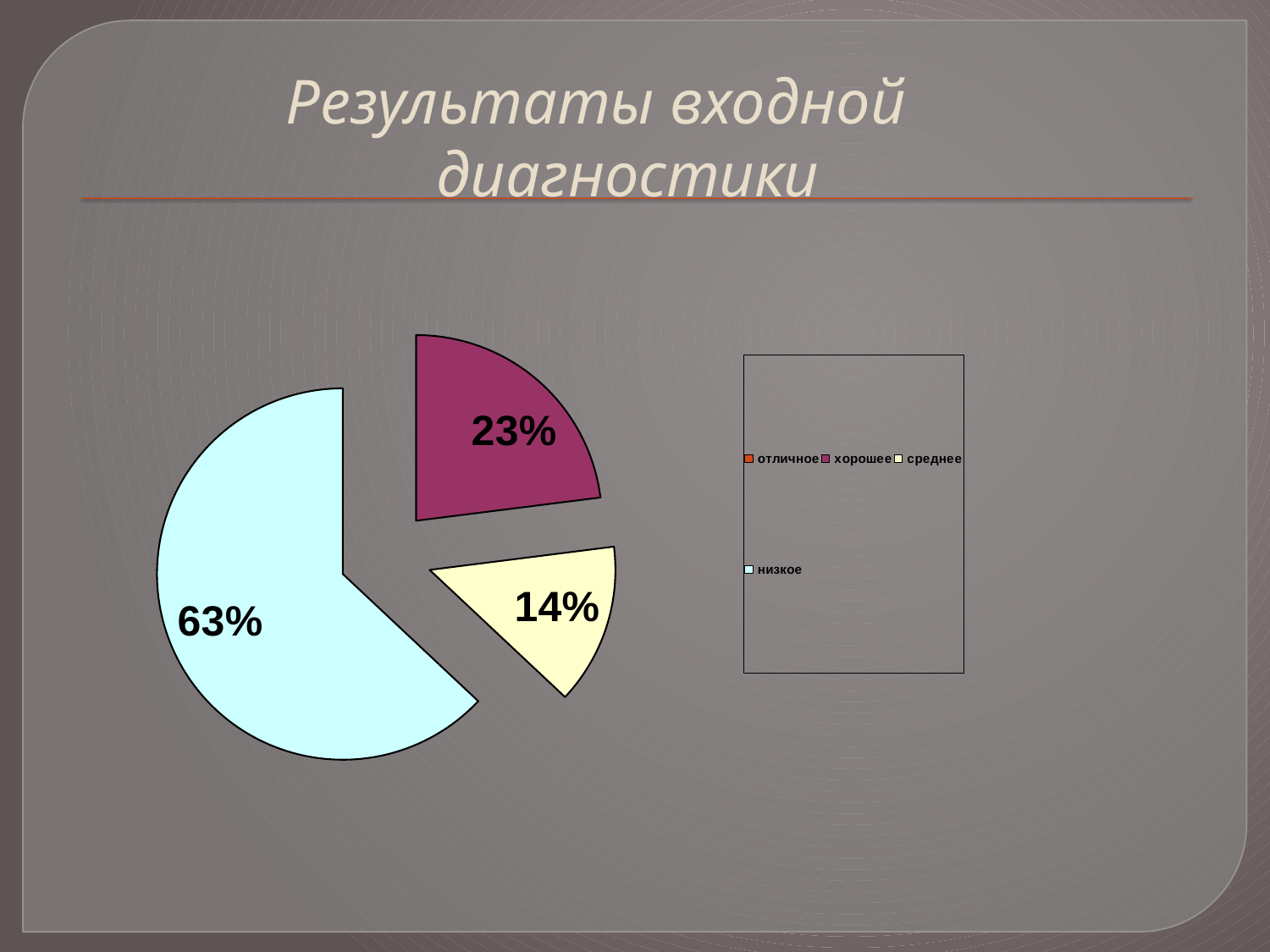
Which slice is larger, 'хорошее' or 'среднее'? хорошее What is the difference in percentage points between the 'низкое' and 'хорошее' slices? 40 Which of the visible slices is the smallest? среднее What share of the pie does the 'хорошее' slice represent? 23% What kind of chart is shown on the slide? pie chart How many entries does the legend list? 4 What is the title of the slide containing the chart? Результаты входной диагностики What is the difference in percentage points between the 'хорошее' and 'среднее' slices? 9 What colour is the 'низкое' slice of the pie? light blue What share of the pie does the 'низкое' slice represent? 63% What share of the pie does the 'среднее' slice represent? 14% Which category has the largest slice of the pie? низкое